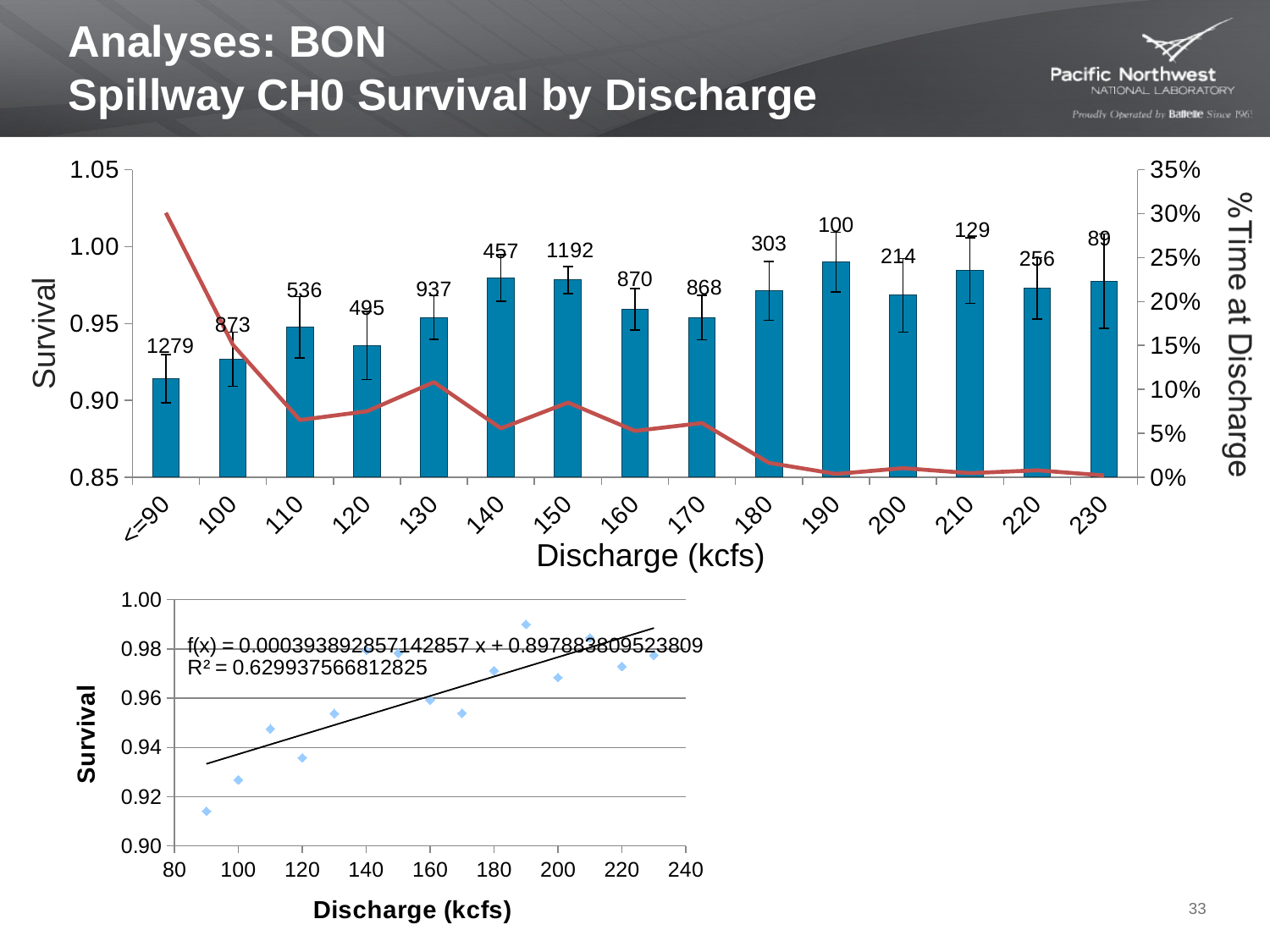
In the top chart, is the Survival value for 140 kcfs greater or less than 0.95? greater In the top chart, what kind of chart shows the Survival values? bar chart In the top chart, what number is printed above the bar for the 230 kcfs category? 89 In the top chart, which discharge category has the lowest Survival bar? <=90 In the top chart, is the Survival value for <=90 kcfs greater or less than 0.95? less In the top chart, what number is printed above the bar for the 150 kcfs category? 1192 In the top chart, is the % Time at Discharge for <=90 kcfs greater or less than 25%? greater In the bottom chart, what R² value is printed for the trendline? 0.629937566812825 In the top chart, how many discharge categories are shown on the x axis? 15 In the top chart, does the % Time at Discharge line generally rise or fall as discharge increases? fall In the bottom chart, do the Survival points generally rise or fall as Discharge increases? rise In the top chart, what number is printed above the bar for the <=90 kcfs category? 1279